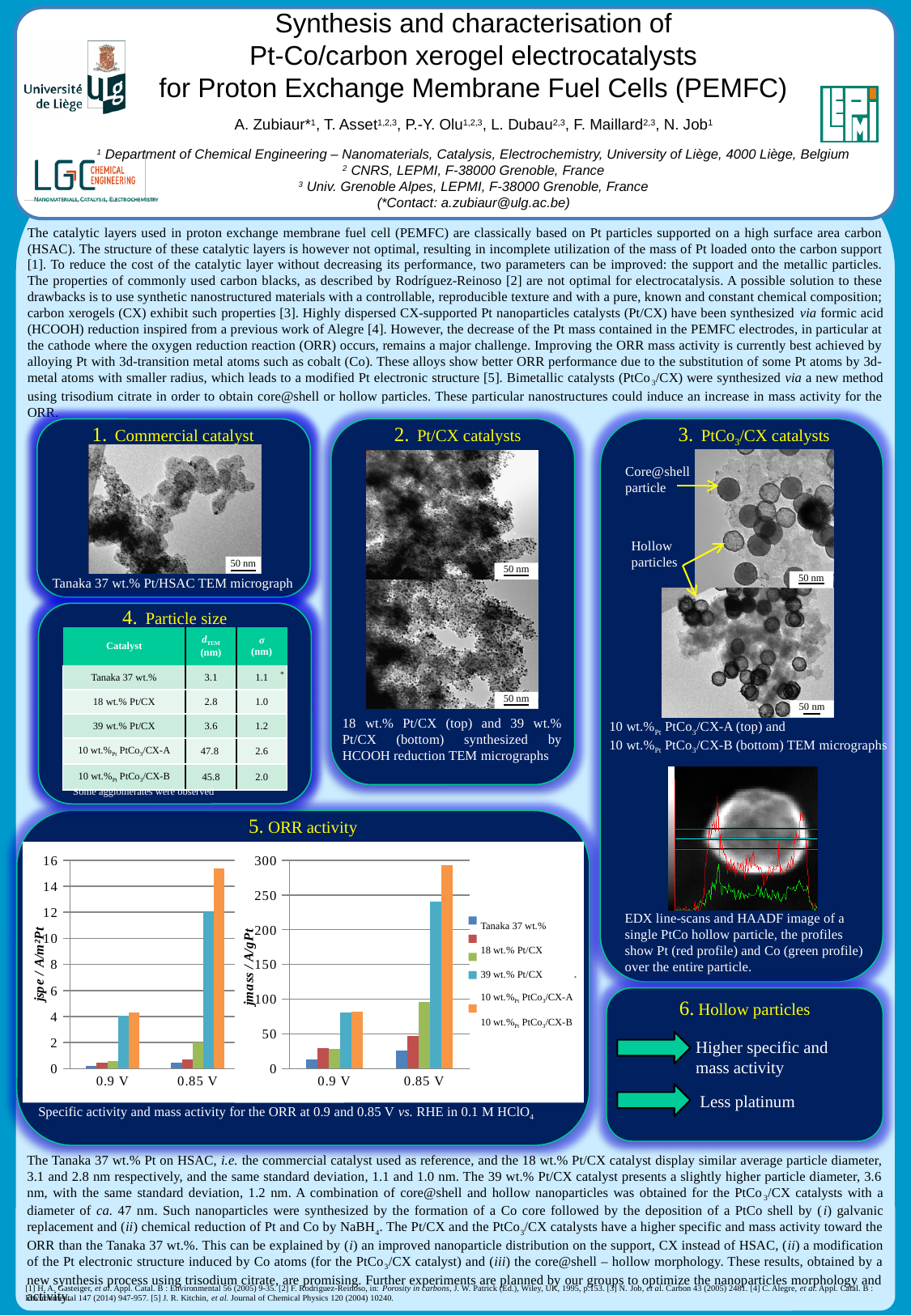
In the left chart (jspe / A/m²Pt), is the value for 10 wt.%Pt PtCo3/CX-A at 0.85 V greater or less than 10? greater In the left chart (jspe / A/m²Pt), which series has the lowest value at 0.85 V? Tanaka 37 wt.% In the right chart (jmass / A/gPt), is the value for 10 wt.%Pt PtCo3/CX-B at 0.85 V greater or less than 250? greater What is the title of the section containing the two bar charts? 5. ORR activity What kind of chart is the left chart in the ORR activity section (jspe / A/m²Pt)? bar chart In the left chart (jspe / A/m²Pt), which is larger at 0.85 V: 39 wt.% Pt/CX or 10 wt.%Pt PtCo3/CX-B? 10 wt.%Pt PtCo3/CX-B In the right chart (jmass / A/gPt), which series has the highest value at 0.85 V? 10 wt.%Pt PtCo3/CX-B How many series does the legend of the ORR activity charts list? 5 In the right chart (jmass / A/gPt), does the value for 10 wt.%Pt PtCo3/CX-B rise or fall from 0.9 V to 0.85 V? rise How many categories are shown on the x axis of the right chart (jmass / A/gPt)? 2 What is the y-axis label of the left chart in the ORR activity section? jspe / A/m²Pt